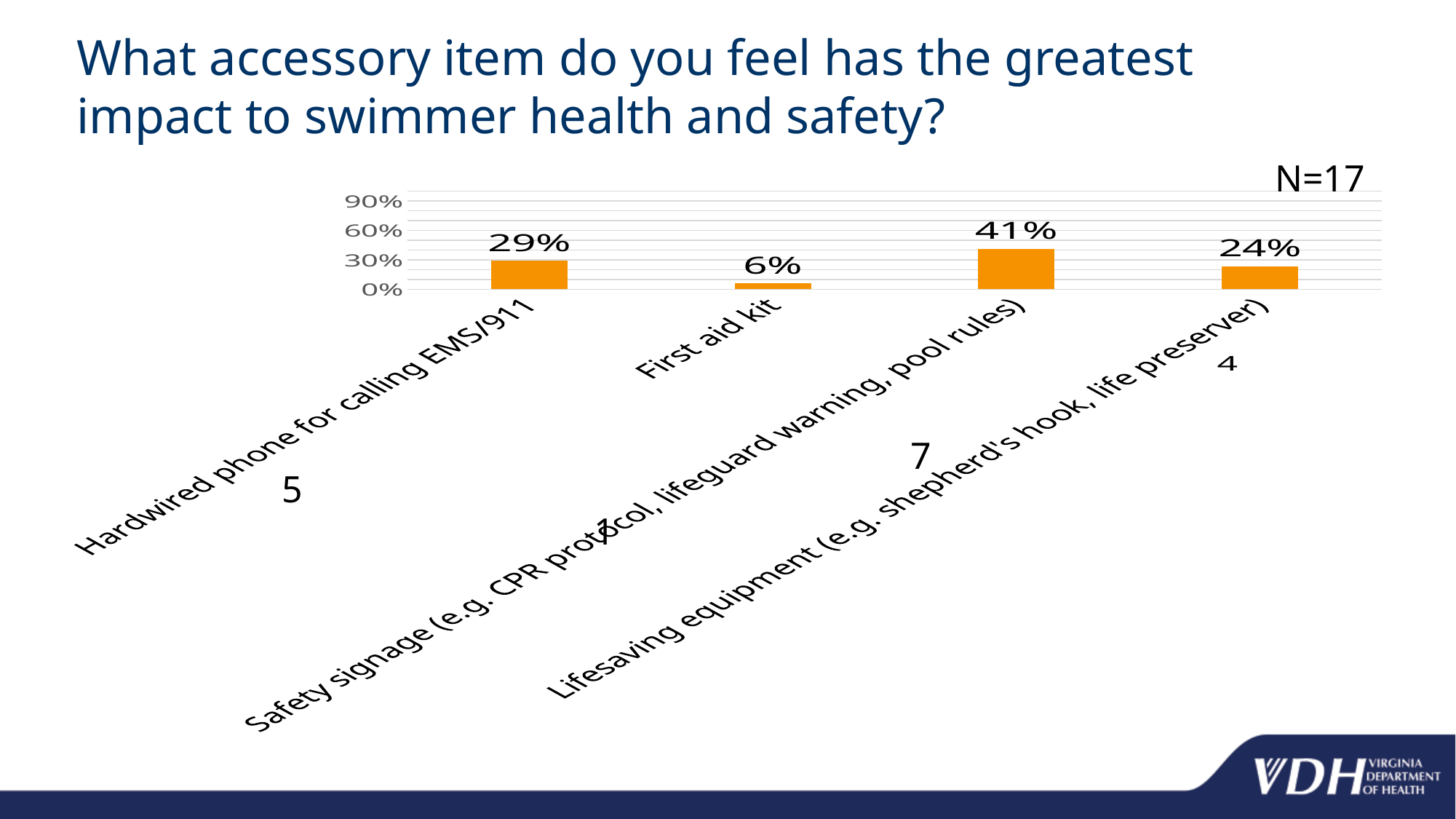
Which accessory item received the highest percentage of responses? Safety signage (e.g. CPR protocol, lifeguard warning, pool rules) What is the difference in percentage points between Safety signage and Hardwired phone for calling EMS/911? 12 Which accessory item received the lowest percentage of responses? First aid kit What is the sample size (N) shown on the slide? N=17 Is the value for Safety signage greater or less than 30%? greater What percentage of respondents chose Safety signage as having the greatest impact to swimmer health and safety? 41% What percentage of respondents chose Hardwired phone for calling EMS/911? 29% How many accessory item categories are shown in the chart? 4 What percentage of respondents chose Lifesaving equipment? 24% What percentage of respondents chose First aid kit? 6% What type of chart is shown on the slide? Bar chart Which received a larger share of responses: Hardwired phone for calling EMS/911 or Lifesaving equipment? Hardwired phone for calling EMS/911